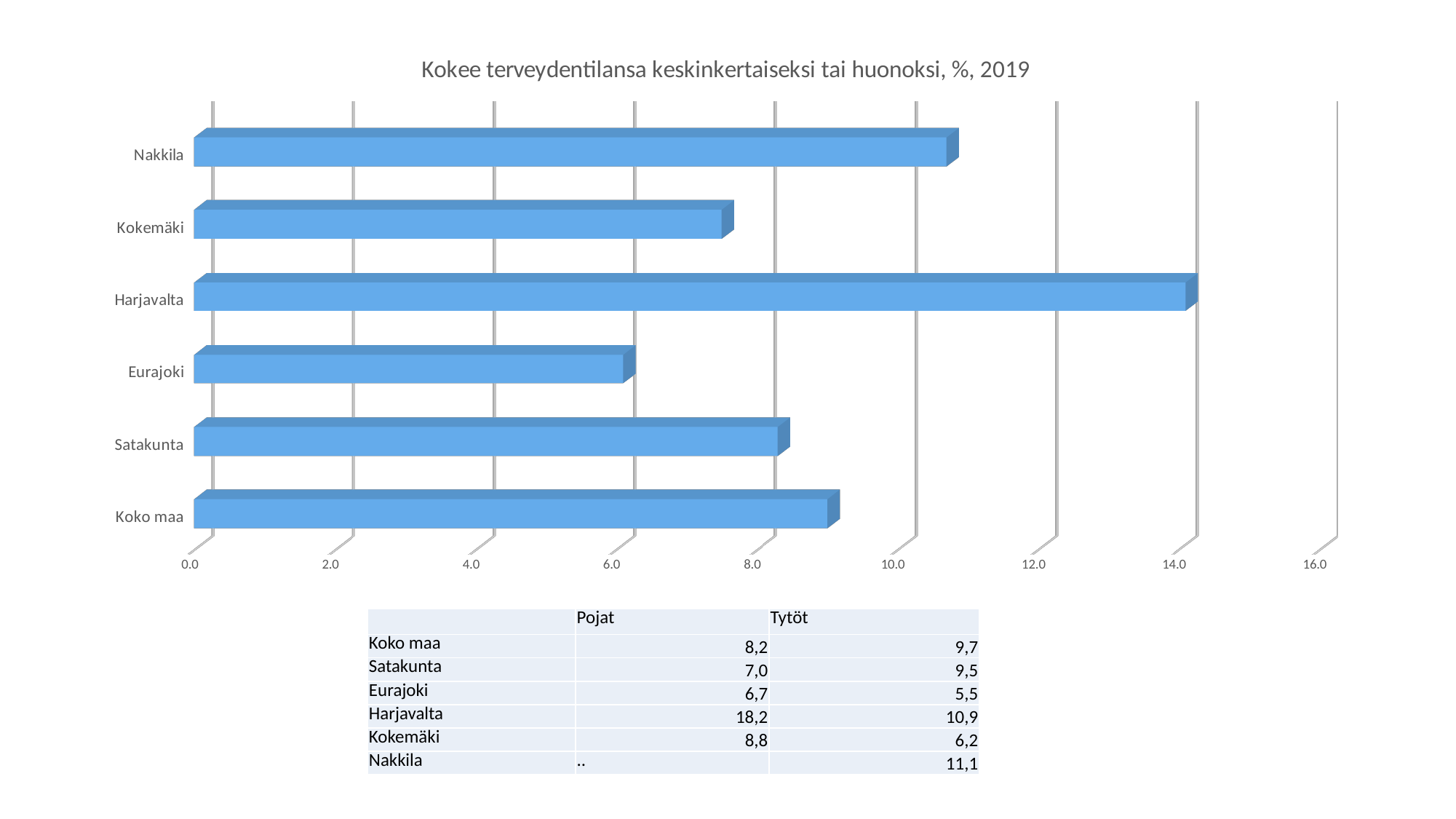
Is the value for Kokemäki greater or less than 8.0? less What is the title of the chart? Kokee terveydentilansa keskinkertaiseksi tai huonoksi, %, 2019 Is the value for Koko maa greater or less than 10.0? less What kind of chart is shown on the slide? bar chart Which has the larger value in the chart, Koko maa or Satakunta? Koko maa Which category has the highest value in the chart? Harjavalta How many categories are plotted in the chart? 6 Is the value for Nakkila greater or less than 10.0? greater Which category has the lowest value in the chart? Eurajoki Which has the larger value in the chart, Nakkila or Kokemäki? Nakkila